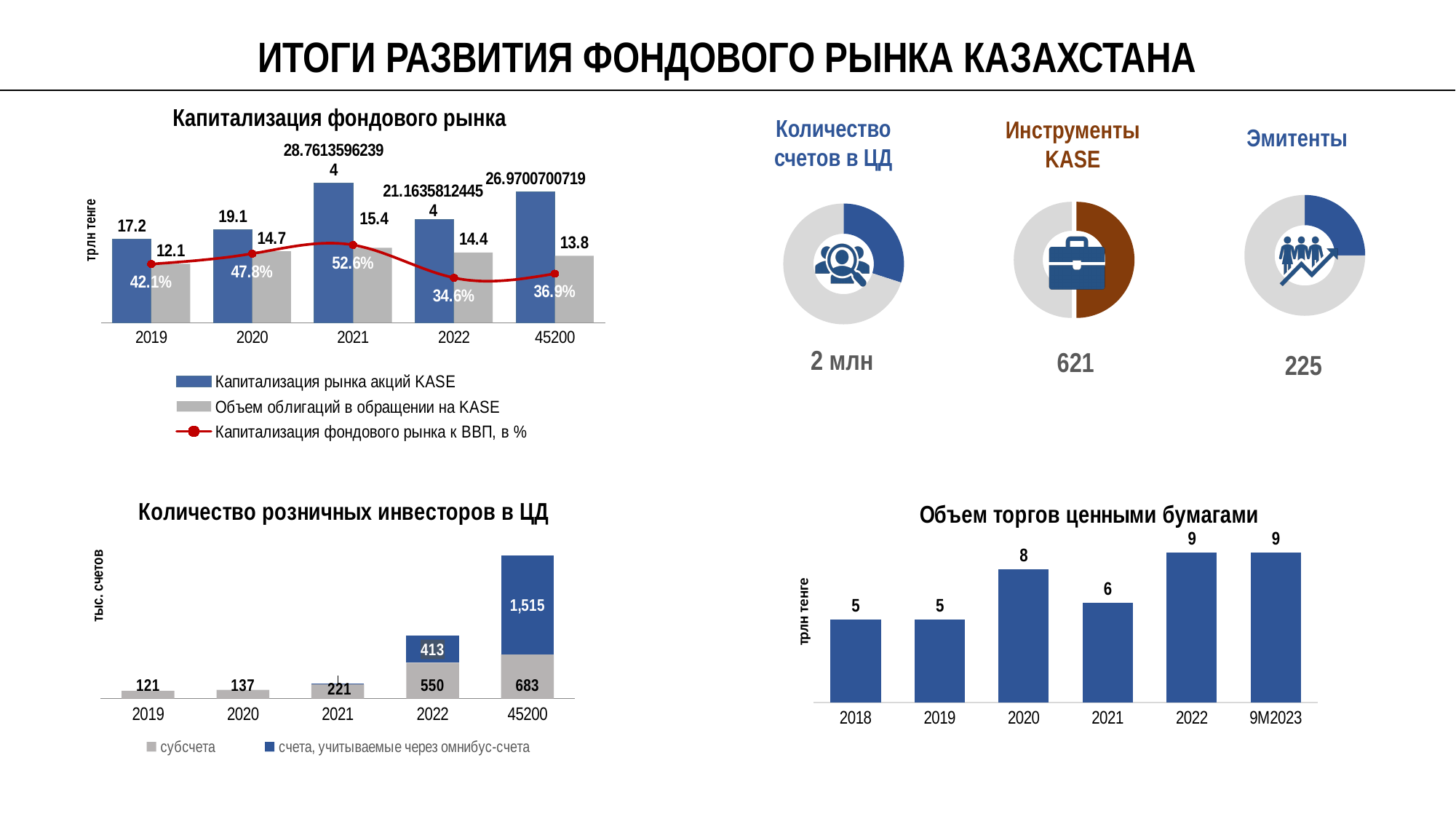
In the chart 'Количество розничных инвесторов в ЦД', what is the value of 'счета, учитываемые через омнибус-счета' for the last category (45200)? 1,515 In the chart 'Объем торгов ценными бумагами', which is larger, the value for 2021 or the value for 2022? 2022 In the chart 'Капитализация фондового рынка', how many series does the legend list? 3 In the chart 'Количество розничных инвесторов в ЦД', what is the total of the stacked bar for 2022? 963 In the chart 'Капитализация фондового рынка', what is the value of 'Капитализация рынка акций KASE' for 2019? 17.2 In the chart 'Капитализация фондового рынка', what is the difference between 'Объем облигаций в обращении на KASE' in 2020 and in 2019? 2.6 In the chart 'Капитализация фондового рынка', what is the value of 'Объем облигаций в обращении на KASE' for 2021? 15.4 In the chart 'Количество розничных инвесторов в ЦД', what is the value of 'субсчета' for 2022? 550 In the chart 'Капитализация фондового рынка', in which year is 'Капитализация фондового рынка к ВВП, в %' highest? 2021 In the chart 'Объем торгов ценными бумагами', how many categories are shown on the x axis? 6 In the chart 'Капитализация фондового рынка', what is the value of 'Капитализация фондового рынка к ВВП, в %' for 2020? 47.8% In the chart 'Объем торгов ценными бумагами', what is the value for 2020? 8